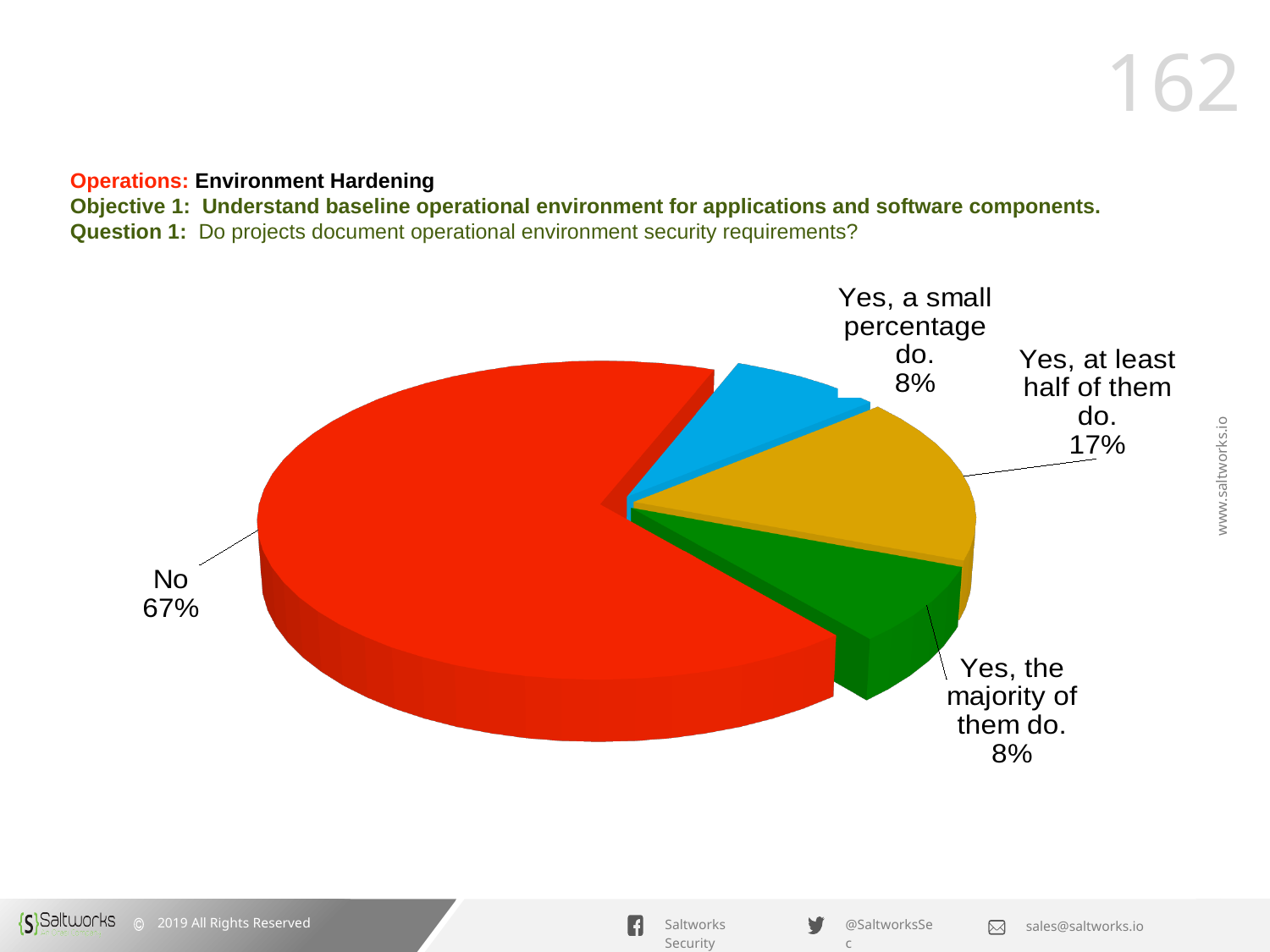
What is the combined percentage of all the "Yes" slices? 33% What percentage of the pie is the "No" slice? 67% Which is larger: the "Yes, at least half of them do." slice or the "Yes, a small percentage do." slice? Yes, at least half of them do. What percentage is shown for "Yes, a small percentage do."? 8% What colour is the "Yes, at least half of them do." slice? Yellow What colour is the "No" slice? Red How many slices does the pie chart have? 4 What percentage is shown for "Yes, at least half of them do."? 17% What is the difference in percentage points between the "No" slice and the "Yes, at least half of them do." slice? 50 What percentage is shown for "Yes, the majority of them do."? 8% Which slice of the pie is the largest? No What kind of chart is shown on the slide? Pie chart